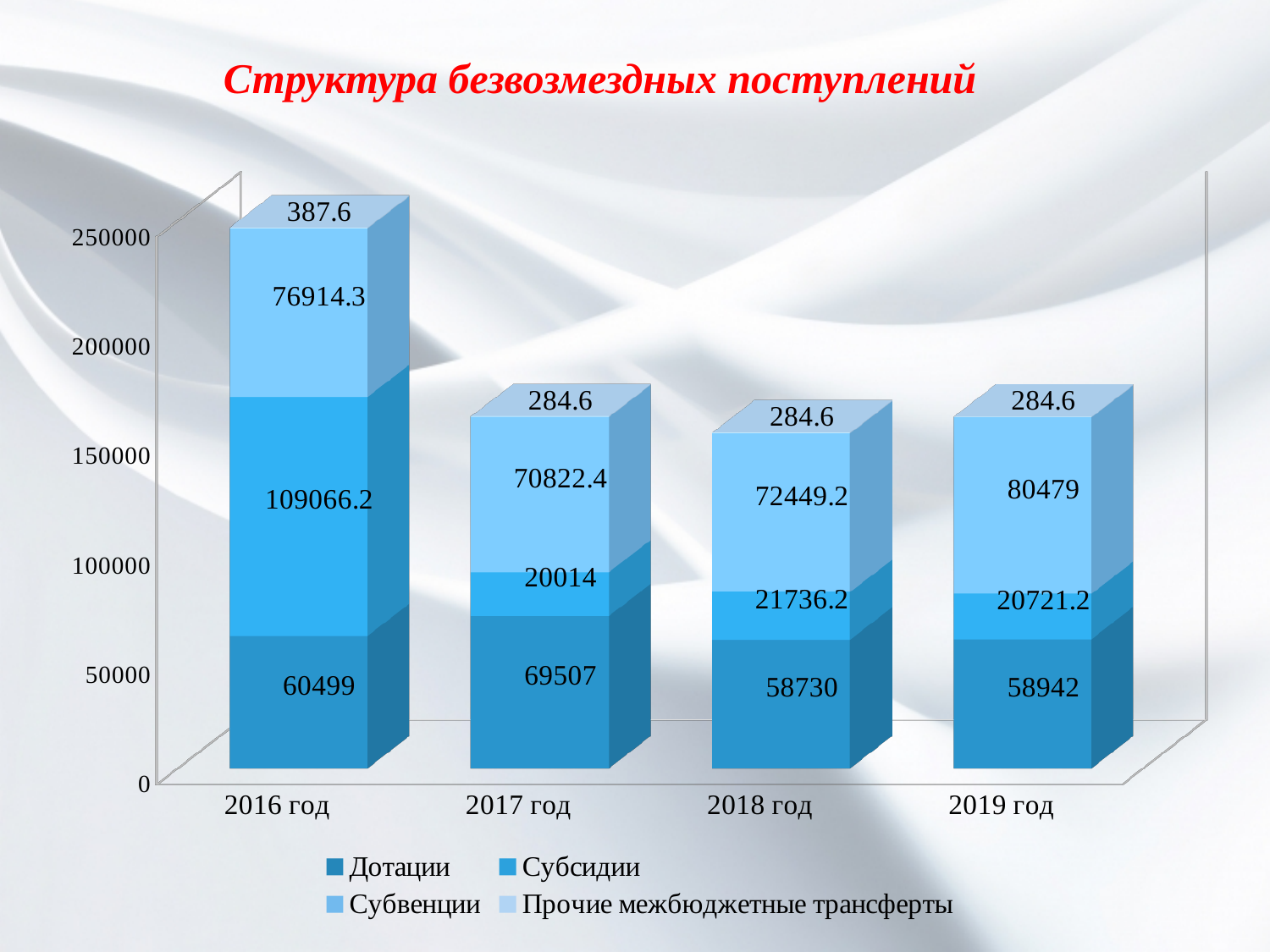
Which is larger: Дотации for 2017 год or Дотации for 2019 год? 2017 год What is the value of Дотации for 2017 год? 69507 What is the value of Субвенции for 2019 год? 80479 What type of chart is shown on the slide? Stacked bar chart In which year is the Дотации value lowest? 2018 год How many years are shown on the x axis? 4 What is the total of the stacked bar for 2017 год? 160628 What is the value of Прочие межбюджетные трансферты for 2016 год? 387.6 What is the difference between the Субвенции values for 2019 год and 2018 год? 8029.8 How many series does the legend list? 4 In which year is the Субсидии value highest? 2016 год What is the value of Субсидии for 2016 год? 109066.2